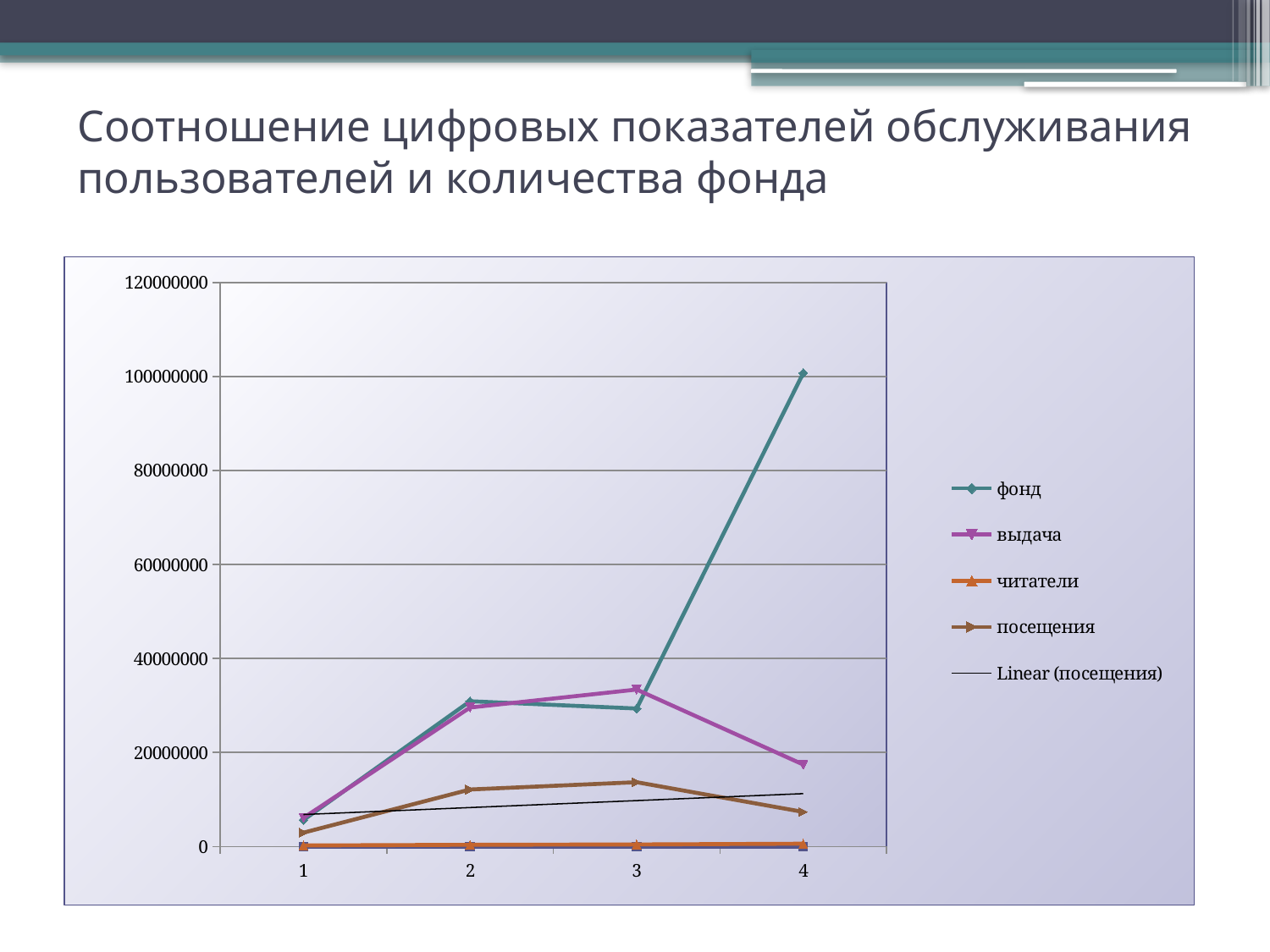
At point 4, which is larger: фонд or выдача? фонд At which x-axis point does the фонд series reach its highest value? 4 Is the value of посещения at point 2 greater or less than 20000000? less Which series stays lowest across the chart? читатели Which series reaches the highest value on the chart? фонд Which legend entry is drawn as a thin black line without markers? Linear (посещения) How many points are there along the x axis? 4 What kind of chart is shown on the slide? line chart Is the value of выдача at point 3 greater or less than 20000000? greater How many series does the legend list? 5 Is the value of фонд at point 4 greater or less than 80000000? greater Does the выдача series rise or fall from point 3 to point 4? fall